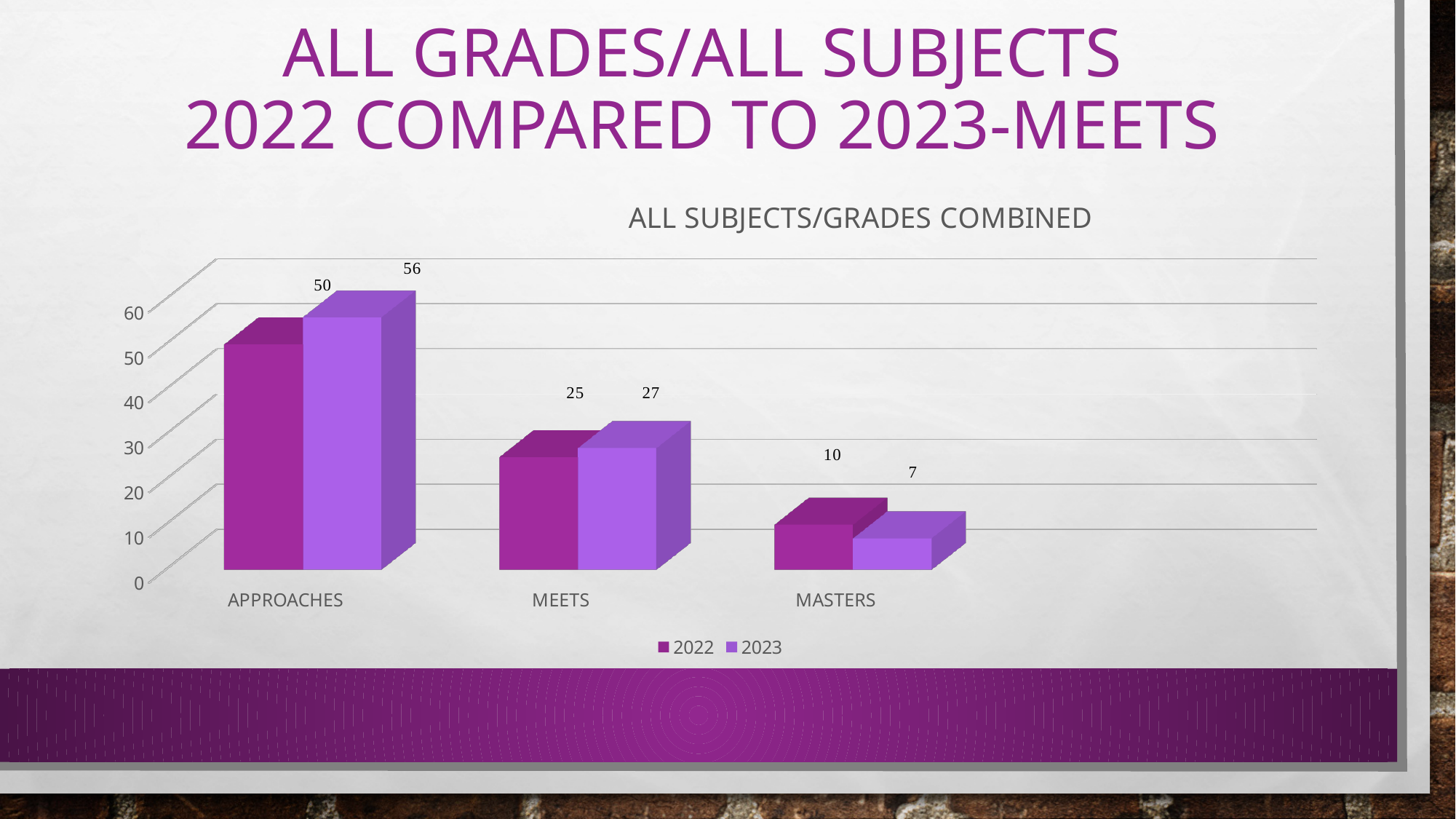
How many series does the legend list? 2 What is the 2022 value for Approaches? 50 How many categories are shown on the x axis? 3 What kind of chart is shown on the slide? Bar chart What is the 2023 value for Meets? 27 For Masters, which year has the larger value, 2022 or 2023? 2022 Which category has the highest 2023 value? Approaches What is the difference between the 2022 and 2023 values for Masters? 3 Which category has the lowest 2022 value? Masters What is the difference between the 2023 and 2022 values for Approaches? 6 What is the 2023 value for Masters? 7 What is the title of the chart? All Subjects/Grades Combined